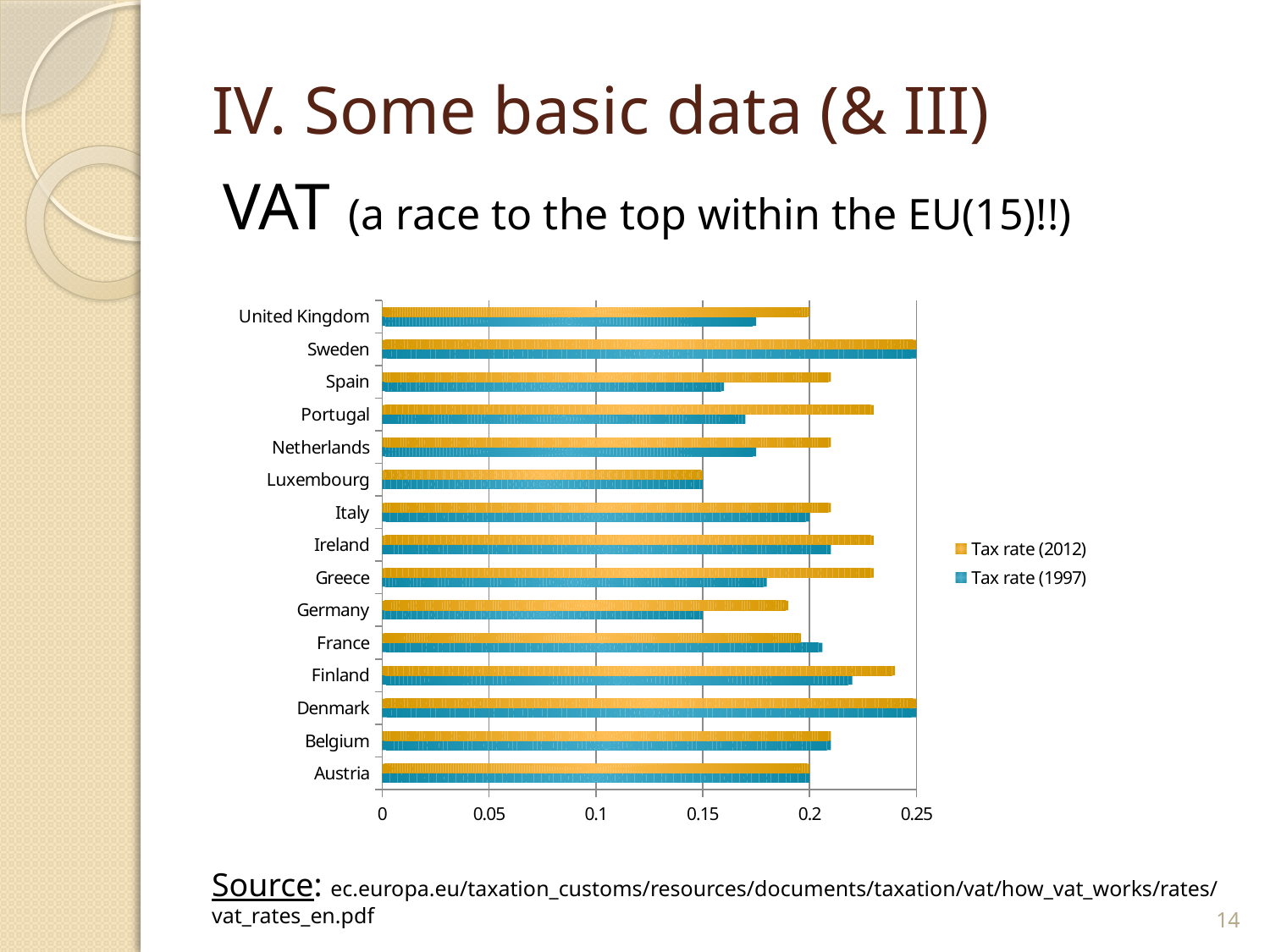
What is the Tax rate (2012) for Sweden? 0.25 For Spain, which is larger: the Tax rate (2012) or the Tax rate (1997)? Tax rate (2012) Which colour represents the Tax rate (2012) series in the legend? orange What is the Tax rate (1997) for Austria? 0.2 Is the Tax rate (1997) for Spain greater or less than 0.2? less Is the Tax rate (2012) for Portugal greater or less than 0.2? greater How many series does the legend list? 2 Which country has the lowest Tax rate (2012)? Luxembourg What is the Tax rate (2012) for Luxembourg? 0.15 How many countries are listed on the chart? 15 Is the Tax rate (2012) for Finland greater or less than 0.2? greater What kind of chart is shown on the slide? bar chart